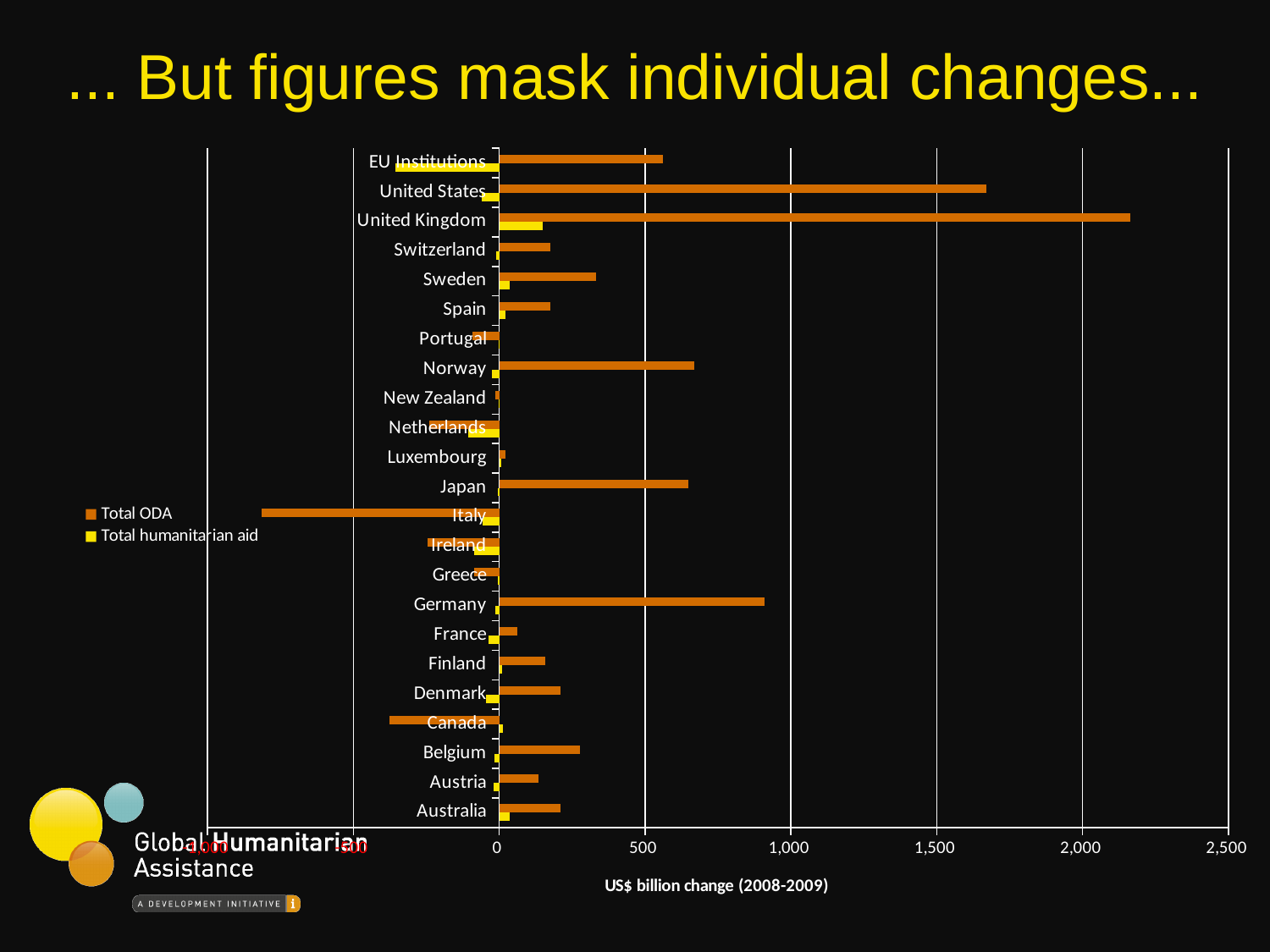
Which category has the highest Total ODA value? United Kingdom Is the Total ODA value for Canada greater or less than 0? less What kind of chart is shown on the slide? bar chart Is the Total ODA value for the United States greater or less than 1,500? greater Is the Total ODA value for Germany greater or less than 500? greater What are the two series named in the legend? Total ODA and Total humanitarian aid Which has the larger Total ODA value, the United States or Germany? United States How many series does the legend list? 2 What is the title of the horizontal axis? US$ billion change (2008-2009) How many countries or institutions are listed on the chart's category axis? 23 Which category has the lowest (most negative) Total ODA value? Italy